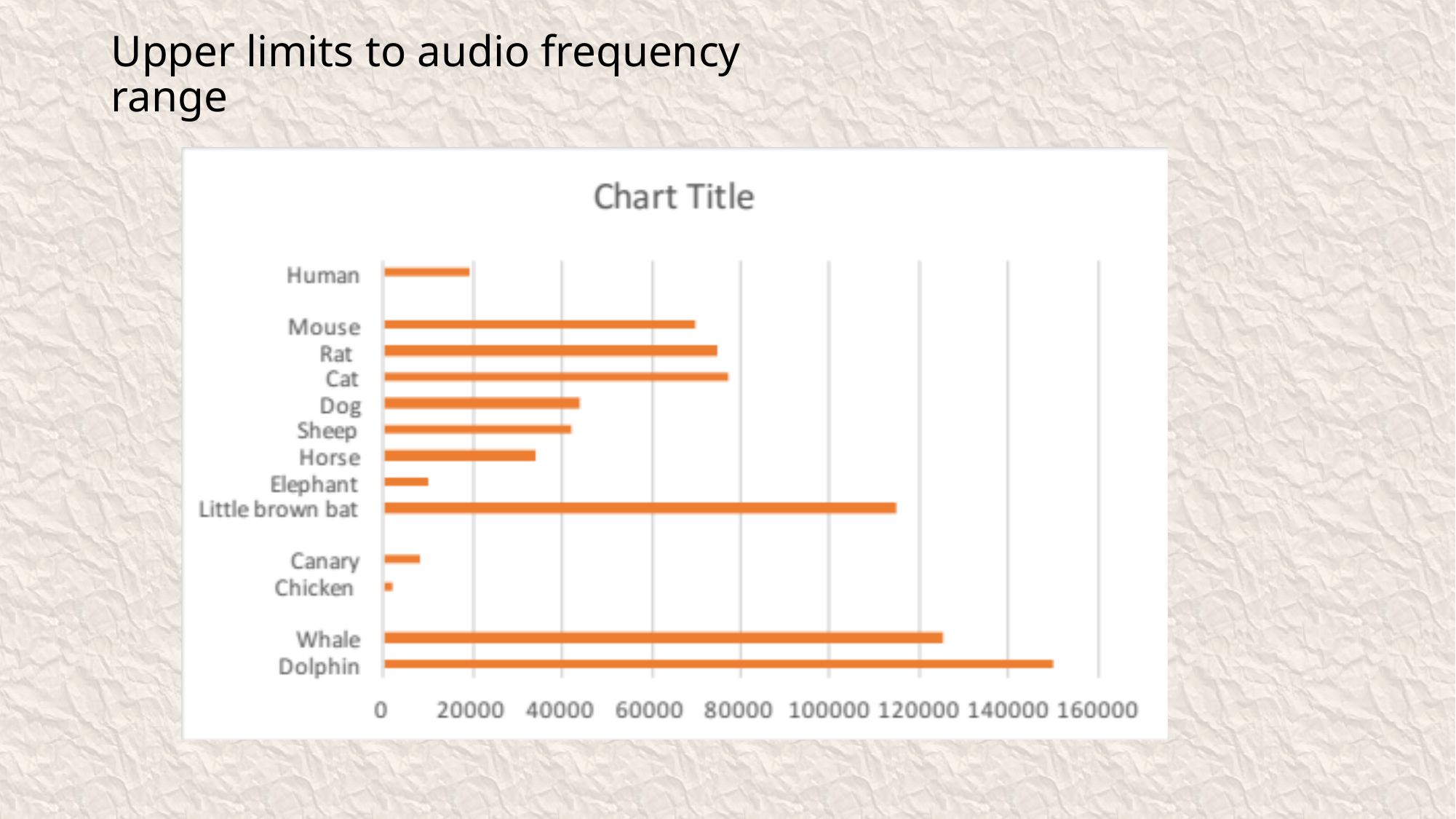
How many animal categories are plotted in the chart? 13 What kind of chart is shown on the slide? Bar chart Which category has the lowest value in the chart? Chicken Which category has the highest value in the chart? Dolphin Which has the larger value, Dog or Horse? Dog Is the value for Horse greater or less than 40000? less Is the value for Little brown bat greater or less than 100000? greater Is the value for Mouse greater or less than 60000? greater What title is printed above the chart? Chart Title Which has the larger value, Whale or Little brown bat? Whale